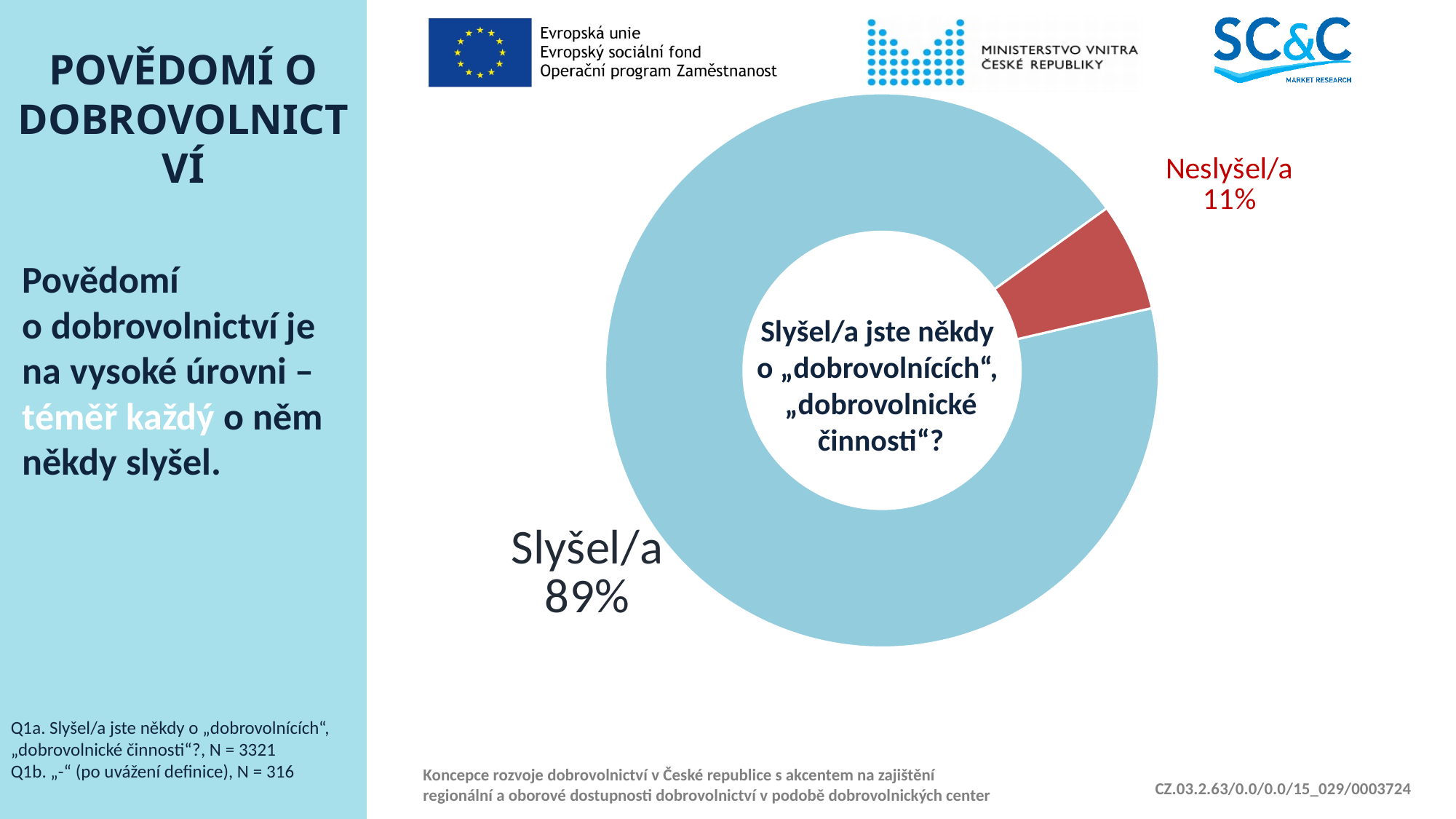
How many categories does the pie chart show? 2 What kind of chart is shown on the slide? Pie chart (doughnut) Which is larger, the share for "Slyšel/a" or for "Neslyšel/a"? Slyšel/a What percentage of respondents answered "Slyšel/a"? 89% Which category has the smallest share of the pie? Neslyšel/a What question is written in the centre of the doughnut chart? Slyšel/a jste někdy o „dobrovolnících“, „dobrovolnické činnosti“? What colour is the "Neslyšel/a" slice? Red What is the difference in percentage points between "Slyšel/a" and "Neslyšel/a"? 78 percentage points What is the total of the two slices shown in the pie chart? 100% What percentage of respondents answered "Neslyšel/a"? 11% Which category has the largest share of the pie? Slyšel/a